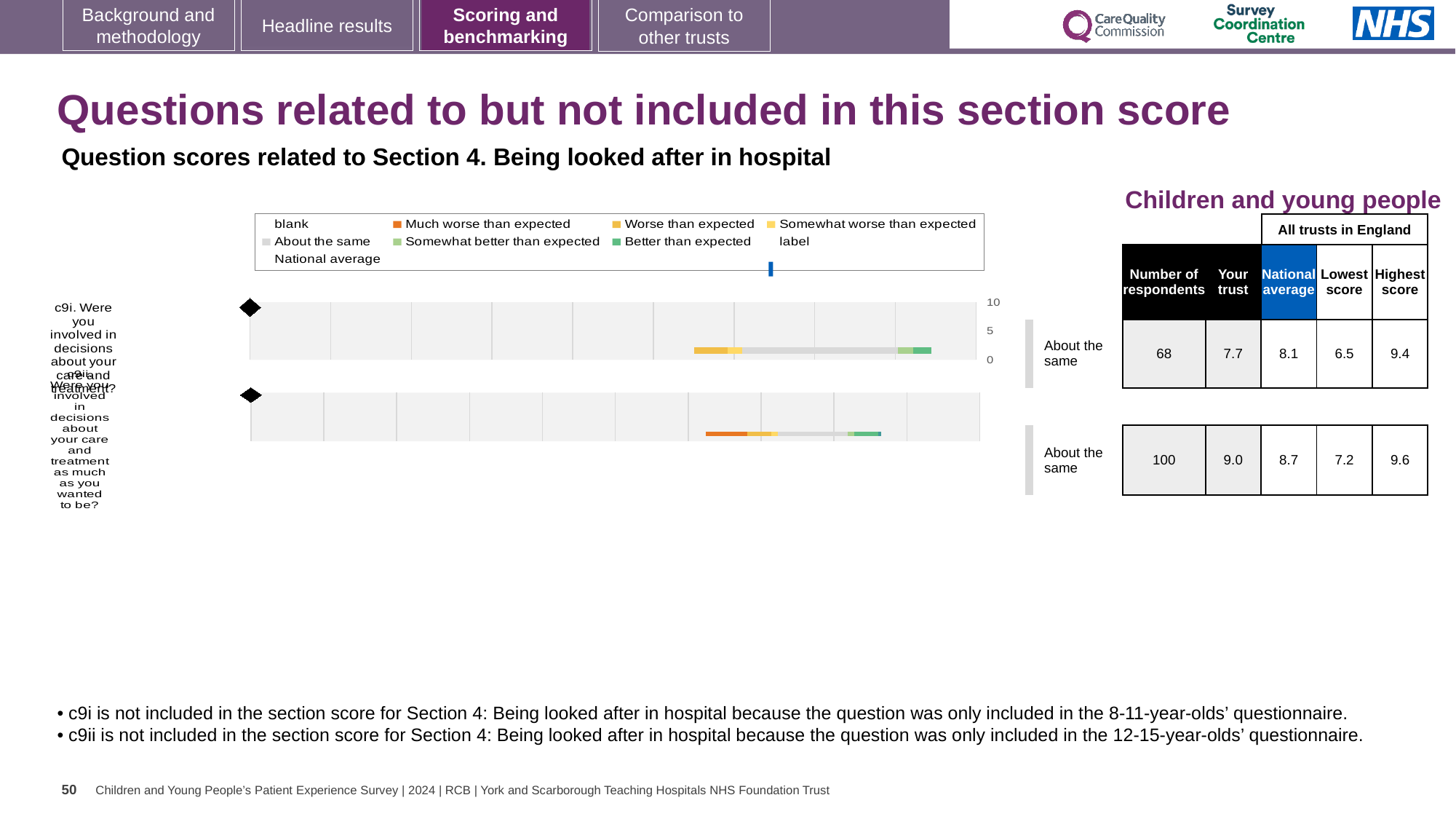
In the table for c9i, how many respondents are listed? 68 In the table for c9i, what is the 'Your trust' score? 7.7 What benchmark category is shown next to the c9i chart? About the same For c9i, what is the difference between the highest score and the lowest score across all trusts in England? 2.9 How many question charts (c9i, c9ii) are shown on the slide? 2 In the table for c9i, what is the national average score? 8.1 What is the highest value shown on the score axis above the c9i chart? 10 In the table for c9ii, how many respondents are listed? 100 What kind of chart is used to show the c9i and c9ii question scores? bar chart For c9i, which is larger: the 'Your trust' score or the national average? National average In the table for c9ii, what is the 'Your trust' score? 9.0 For c9ii, which is larger: the 'Your trust' score or the national average? Your trust